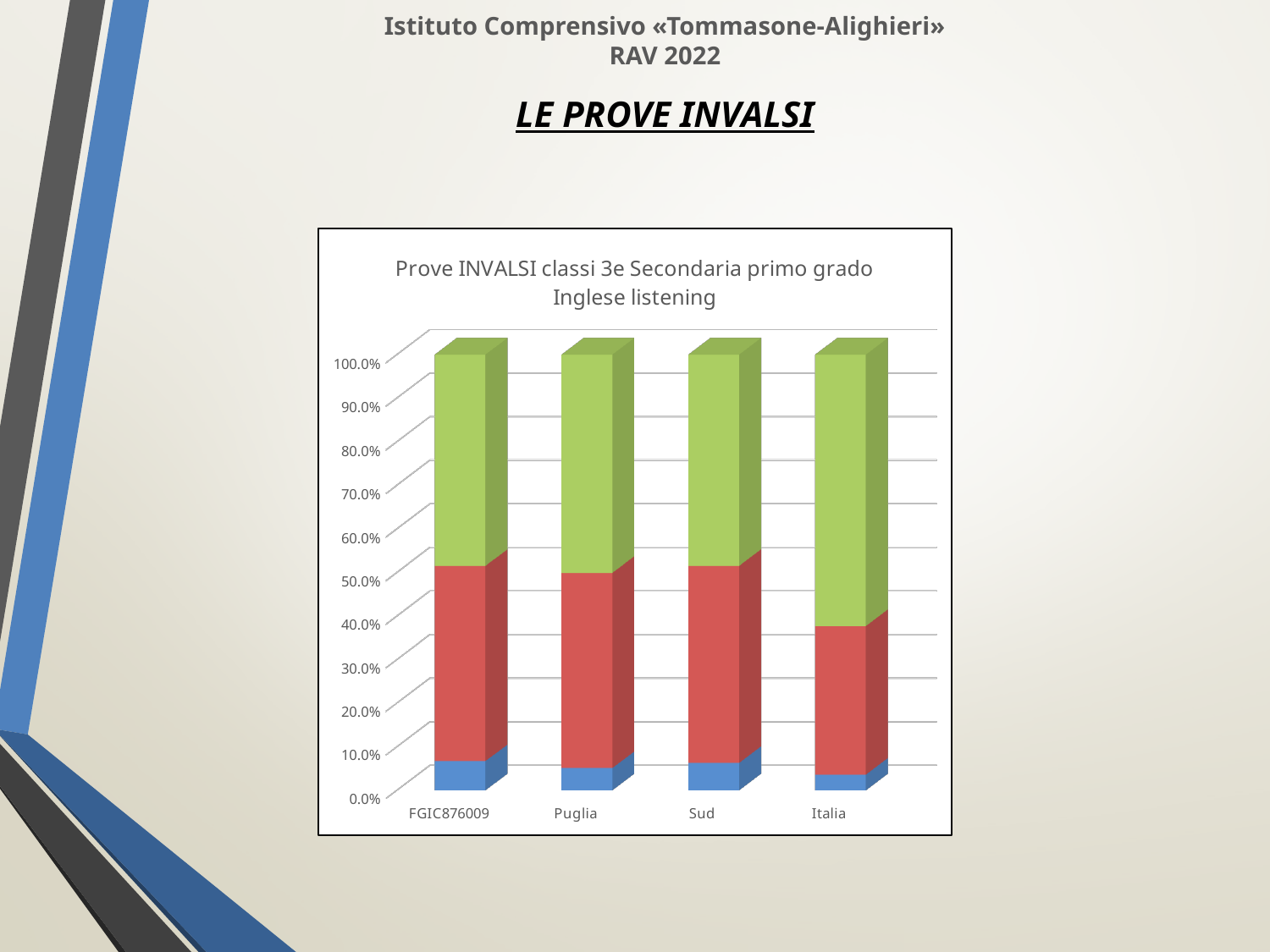
What total does each stacked bar reach on the vertical axis? 100.0% Which is larger, the green segment for Italia or the green segment for FGIC876009? Italia How many categories are shown on the x axis of the chart? 4 What kind of chart is shown on the slide? Stacked bar chart Which category has the smallest red segment? Italia How many coloured segments make up each stacked bar? 3 Which category has the largest green segment? Italia What is the title of the chart? Prove INVALSI classi 3e Secondaria primo grado Inglese listening Which is larger, the red segment for Sud or the red segment for Italia? Sud Is the red segment for Puglia greater or less than 30.0%? greater Is the green segment for Italia greater or less than 50.0%? greater Is the blue segment for Italia greater or less than 10.0%? less